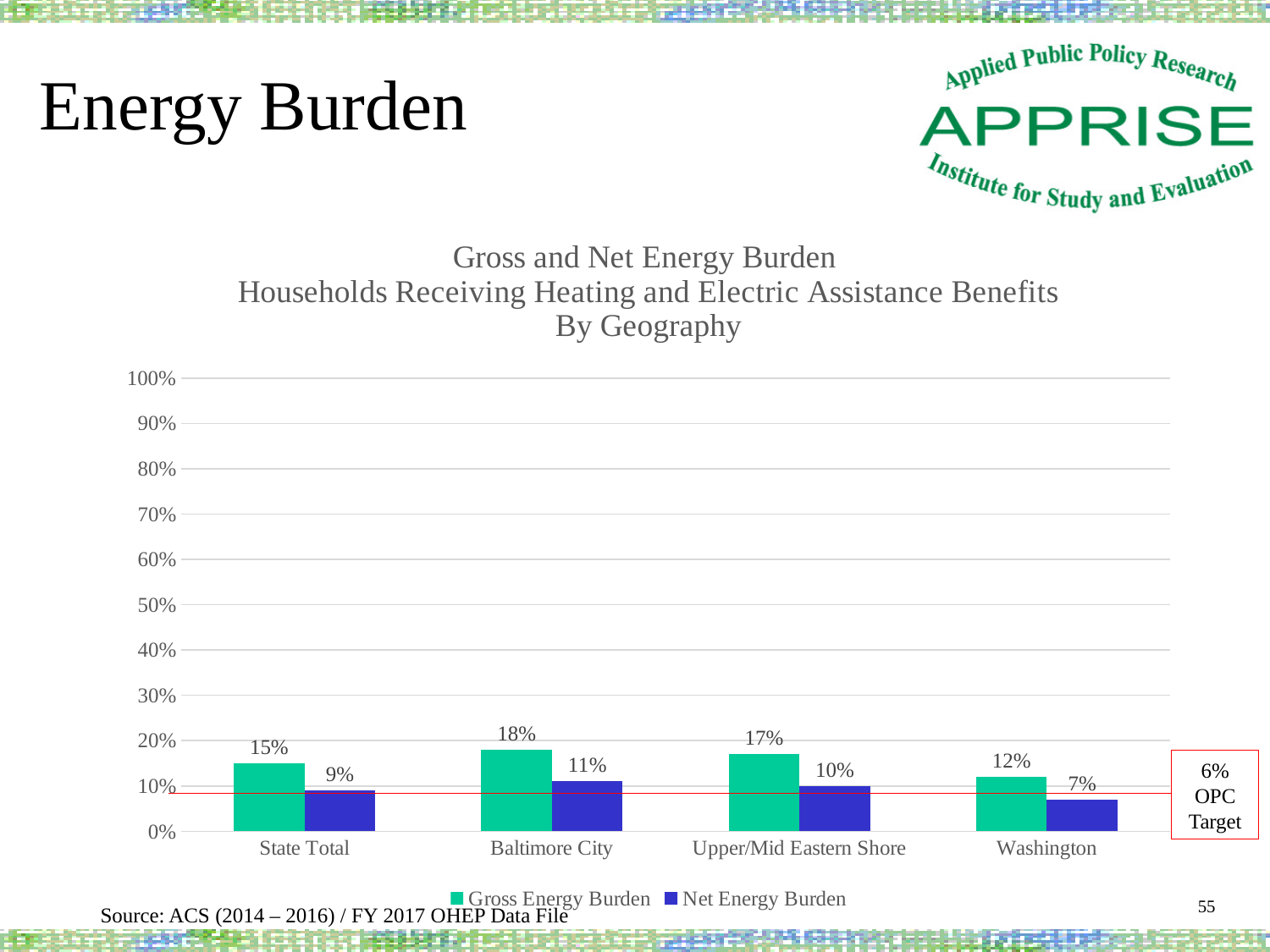
What is the difference between the Gross and Net Energy Burden for Upper/Mid Eastern Shore? 7% What kind of chart is shown on the slide? bar chart How many series does the legend list? 2 What is the Net Energy Burden for the State Total? 9% How many geographies are shown on the x axis? 4 What is the OPC Target value shown in the box at the right of the chart? 6% Which geography has the lowest Net Energy Burden? Washington Is the Gross Energy Burden for Upper/Mid Eastern Shore greater or less than 20%? less Which is larger, the Gross Energy Burden for Washington or the Net Energy Burden for Baltimore City? Gross Energy Burden for Washington What is the Net Energy Burden for Washington? 7% Which geography has the highest Gross Energy Burden? Baltimore City What is the Gross Energy Burden for Baltimore City? 18%